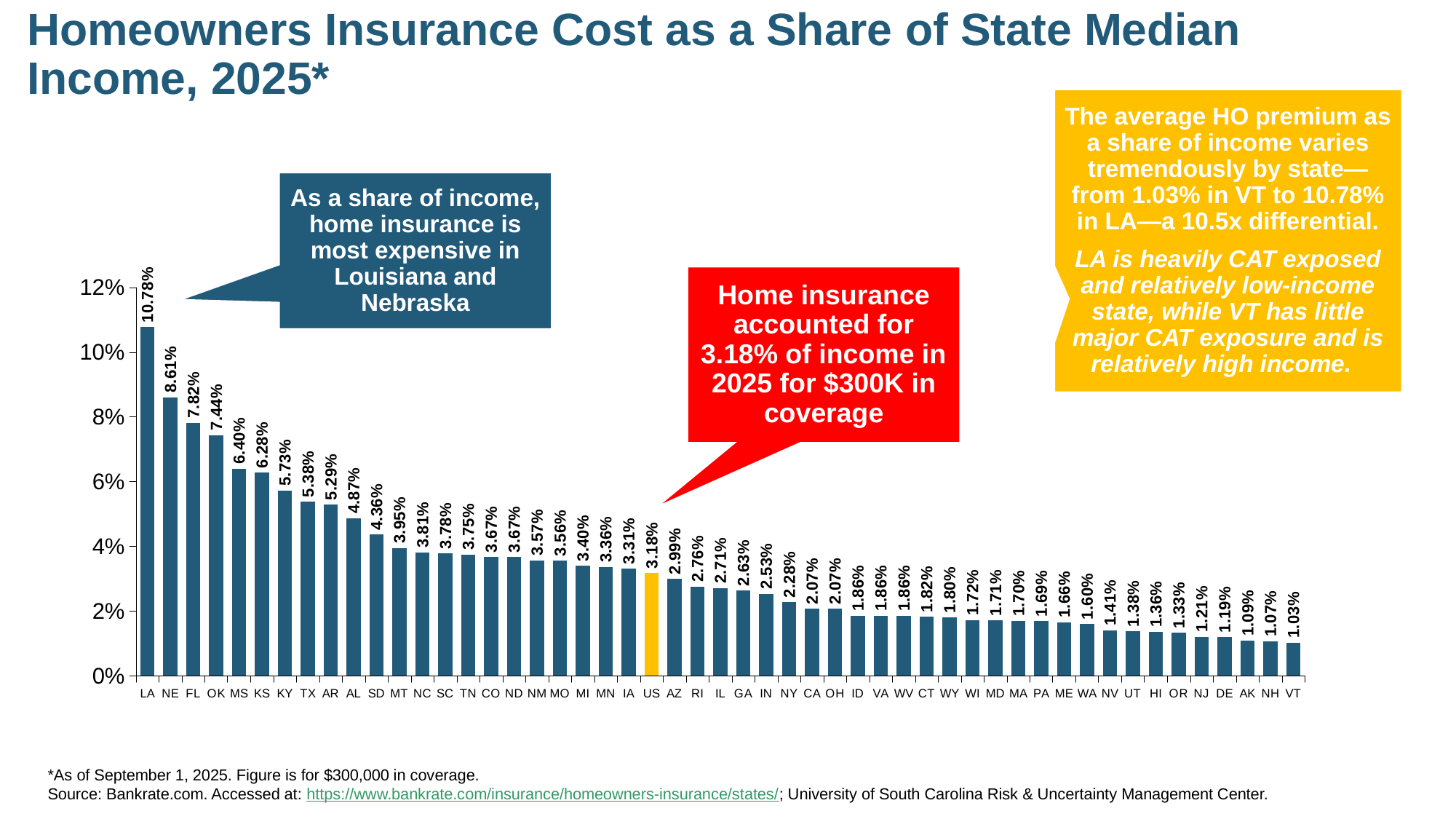
How many bars are plotted in the chart? 51 Which bar is highlighted in a different colour (yellow) from the rest? US Is the value for Nebraska (NE) greater or less than 8%? greater What is the homeowners insurance cost as a share of median income for Louisiana (LA)? 10.78% What is the difference in percentage points between the values for LA and VT? 9.75 percentage points Which has a higher value, Florida (FL) or Oklahoma (OK)? FL What is the value shown for Texas (TX)? 5.38% What type of chart is shown on the slide? bar chart What is the value shown for the US bar? 3.18% Which state has the lowest homeowners insurance cost as a share of median income? VT Do the values rise or fall moving from left to right along the x axis? fall Which state has the highest homeowners insurance cost as a share of median income? LA